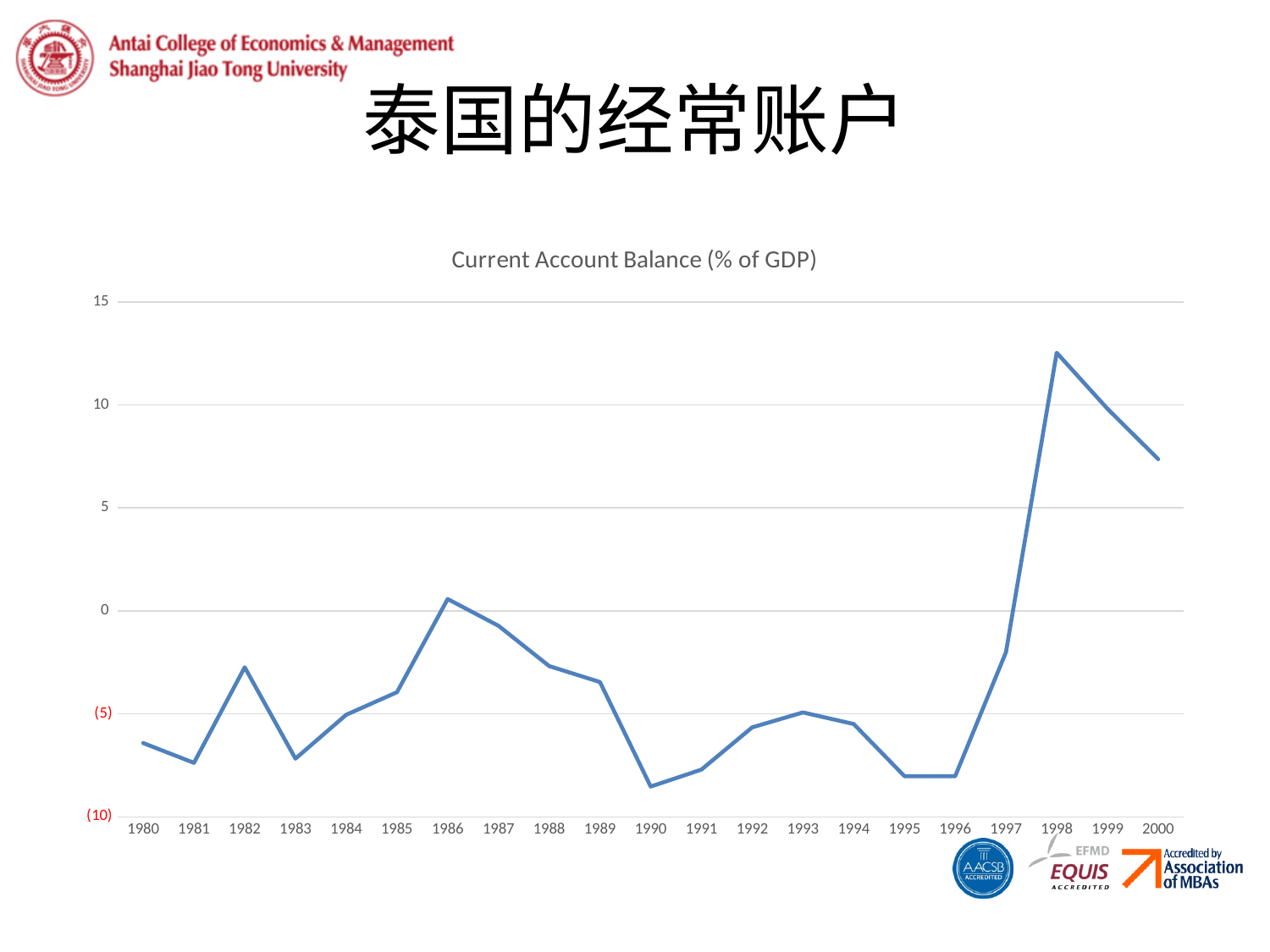
Which year has the larger value, 1982 or 1983? 1982 Is the value for 1998 greater or less than 10? greater Which year has the larger value, 1998 or 2000? 1998 Is the value for 1990 greater or less than (5)? less Is the value for 1986 greater or less than 0? greater What is the title of the chart? Current Account Balance (% of GDP) Do the values rise or fall from 1998 to 2000? fall What kind of chart is shown on the slide? line chart How many years are plotted along the x axis of the chart? 21 Which year has the highest current account balance in the chart? 1998